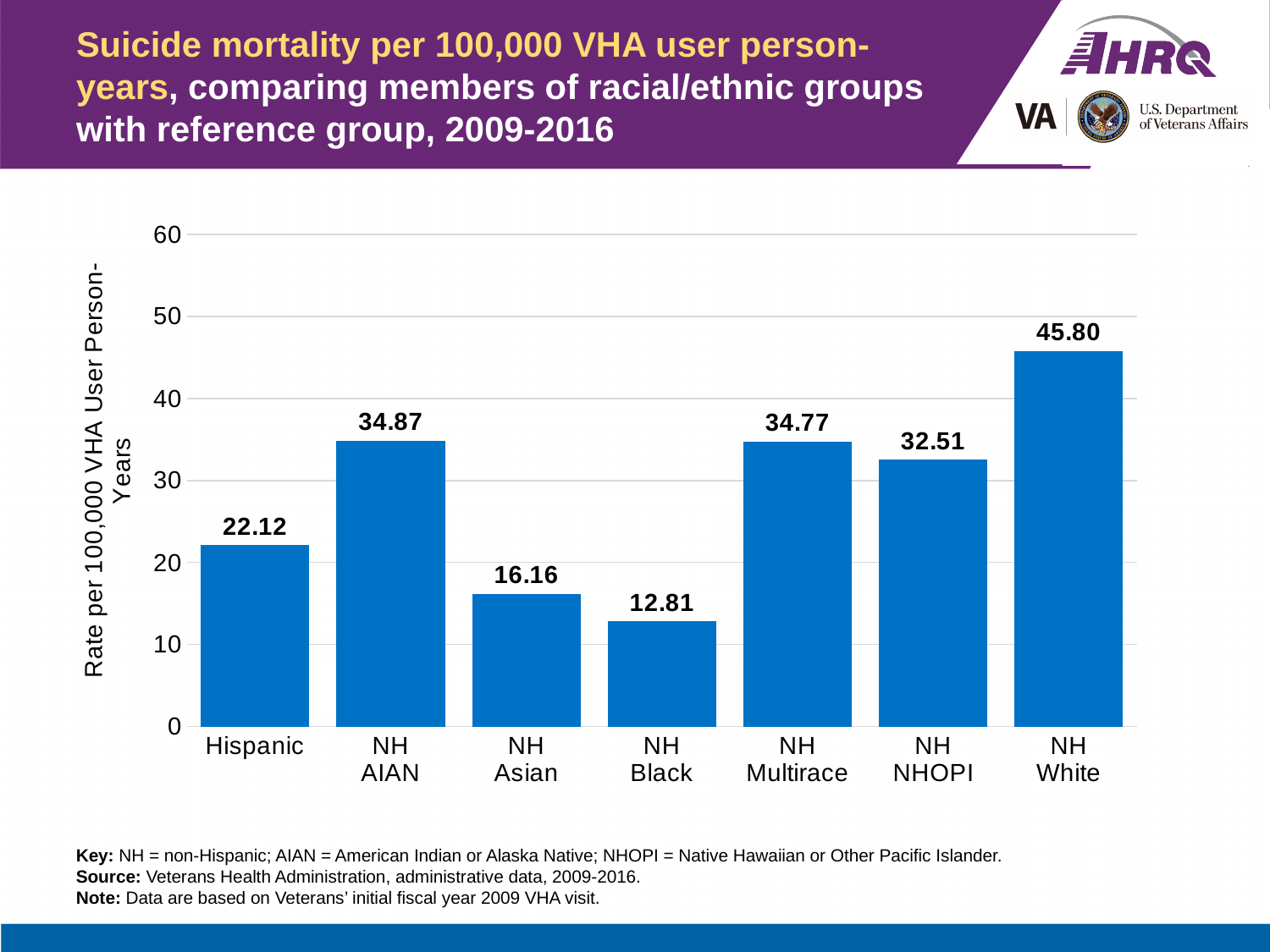
What is the label of the vertical axis? Rate per 100,000 VHA User Person-Years What is the rate for NH NHOPI Veterans? 32.51 What is the rate for NH Black Veterans? 12.81 Is the rate for NH Multirace Veterans greater or less than 30? greater What kind of chart is shown on the slide? Bar chart How many racial/ethnic groups are shown on the chart? 7 Which group has a higher rate, NH Asian or Hispanic? Hispanic What is the difference between the rates for NH AIAN and Hispanic Veterans? 12.75 What is the difference between the rates for NH White and NH Black Veterans? 32.99 What is the suicide mortality rate per 100,000 VHA user person-years for Hispanic Veterans? 22.12 Which racial/ethnic group has the lowest suicide mortality rate? NH Black Which racial/ethnic group has the highest suicide mortality rate? NH White